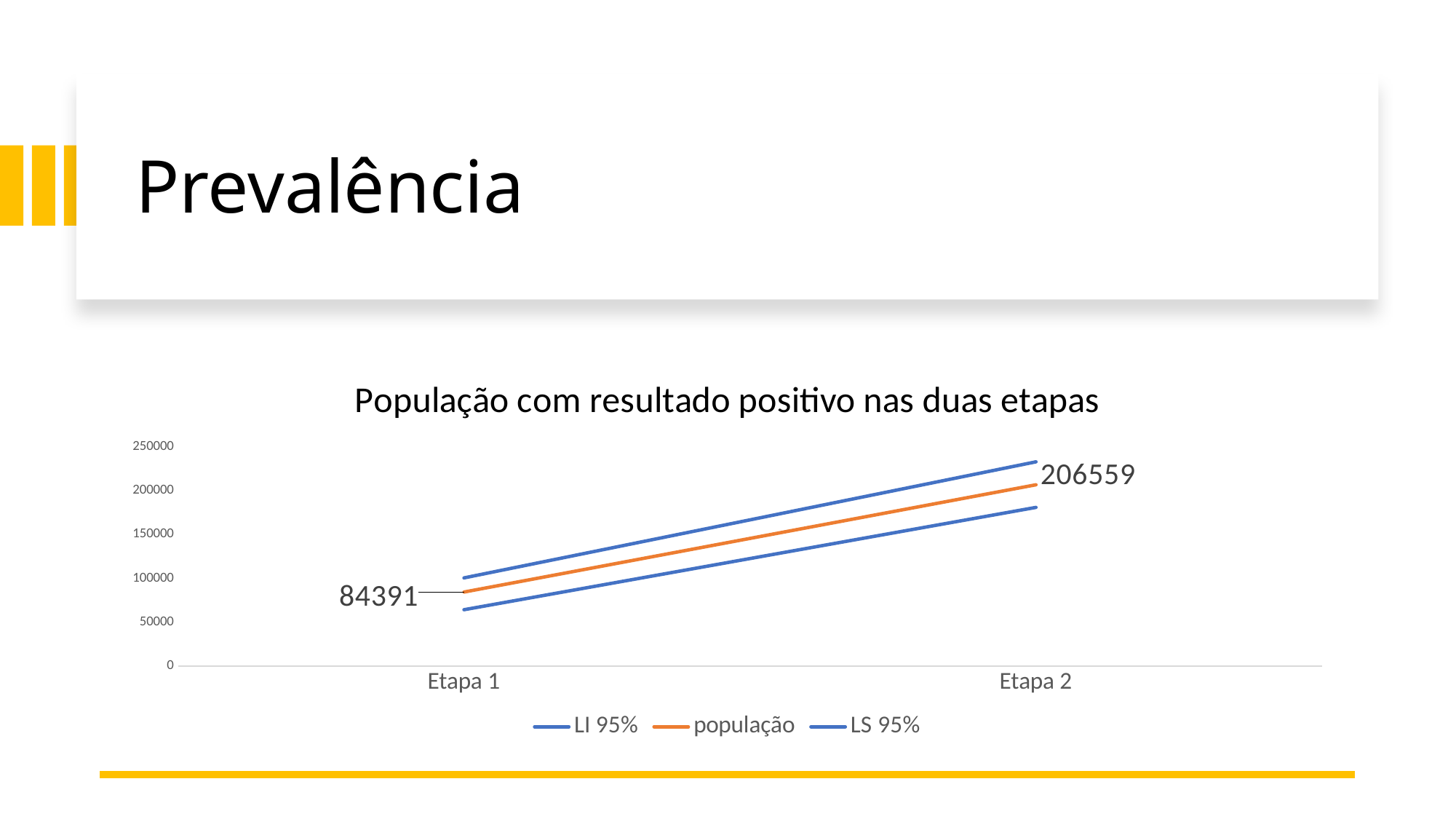
What is the value of the população series at Etapa 1? 84391 Which category has the higher população value, Etapa 1 or Etapa 2? Etapa 2 Does the população series rise or fall from Etapa 1 to Etapa 2? rise How many series does the legend list? 3 What is the title of the chart? População com resultado positivo nas duas etapas What is the difference between the população values at Etapa 2 and Etapa 1? 122168 What type of chart is shown on the slide? line chart Is the value for LS 95% at Etapa 2 greater or less than 200000? greater What is the value of the população series at Etapa 2? 206559 Is the value for LI 95% at Etapa 2 greater or less than 200000? less How many categories are shown on the x axis? 2 Is the value for LI 95% at Etapa 1 greater or less than 100000? less